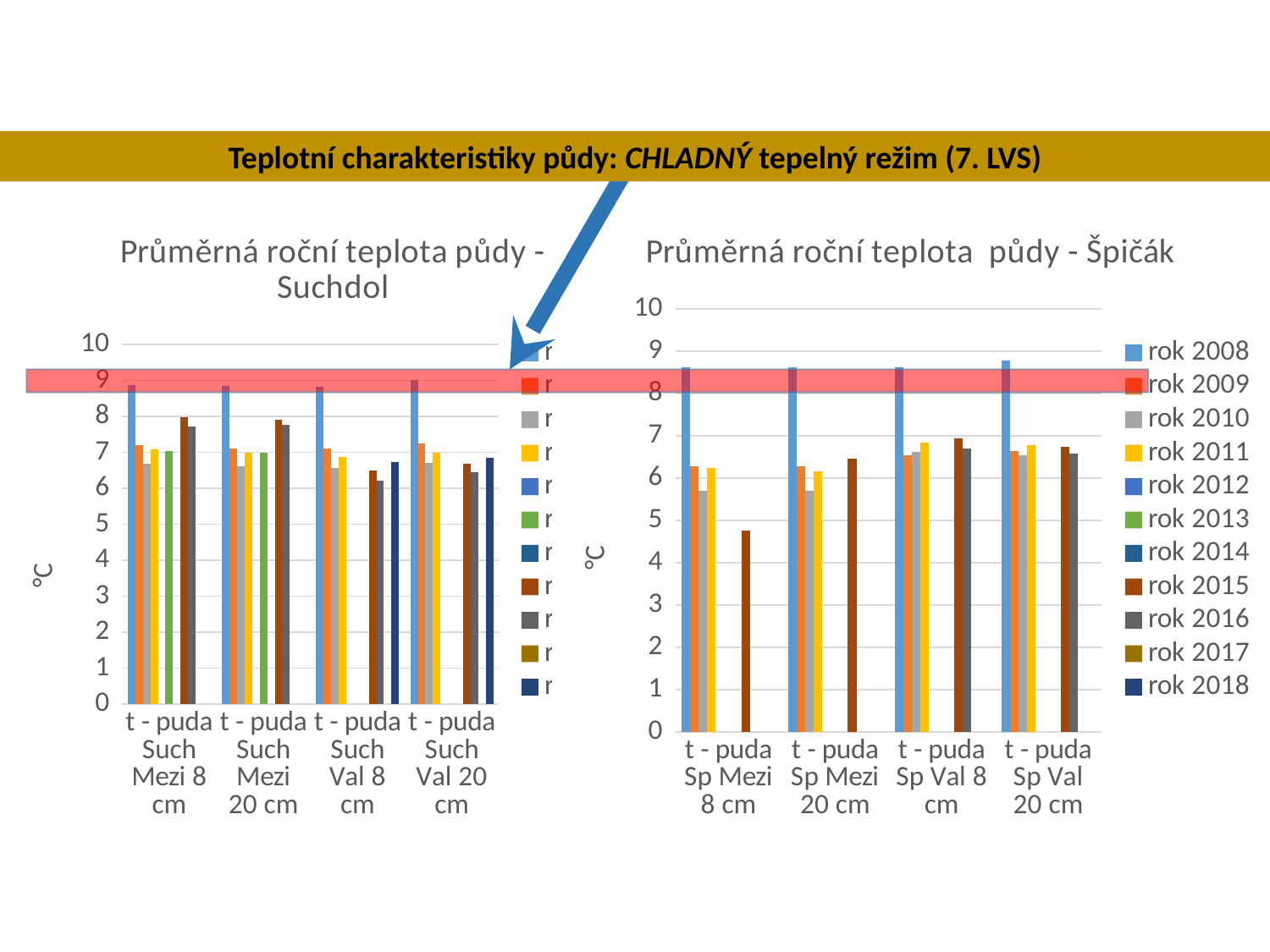
On the chart titled "Průměrná roční teplota půdy - Špičák", is the value of rok 2010 for "t - puda Sp Mezi 20 cm" greater or less than 7? less On the chart titled "Průměrná roční teplota půdy - Špičák", how many categories are shown on the x axis? 4 What kind of chart is the one titled "Průměrná roční teplota půdy - Špičák"? bar chart On the chart titled "Průměrná roční teplota půdy - Suchdol", how many categories are shown on the x axis? 4 On the chart titled "Průměrná roční teplota půdy - Špičák", is the value of rok 2015 for "t - puda Sp Mezi 8 cm" greater or less than 6? less What is the title of the chart on the left side of the slide? Průměrná roční teplota půdy - Suchdol On the chart titled "Průměrná roční teplota půdy - Špičák", which series has the lowest value for "t - puda Sp Mezi 8 cm"? rok 2015 What is the label on the vertical axis of the chart titled "Průměrná roční teplota půdy - Špičák"? °C On the chart titled "Průměrná roční teplota půdy - Špičák", which is larger for "t - puda Sp Val 8 cm": rok 2008 or rok 2016? rok 2008 On the chart titled "Průměrná roční teplota půdy - Špičák", which series has the highest value for "t - puda Sp Mezi 8 cm"? rok 2008 On the chart titled "Průměrná roční teplota půdy - Špičák", how many series does the legend list? 11 On the chart titled "Průměrná roční teplota půdy - Špičák", is the value of rok 2008 for "t - puda Sp Val 20 cm" greater or less than 8? greater